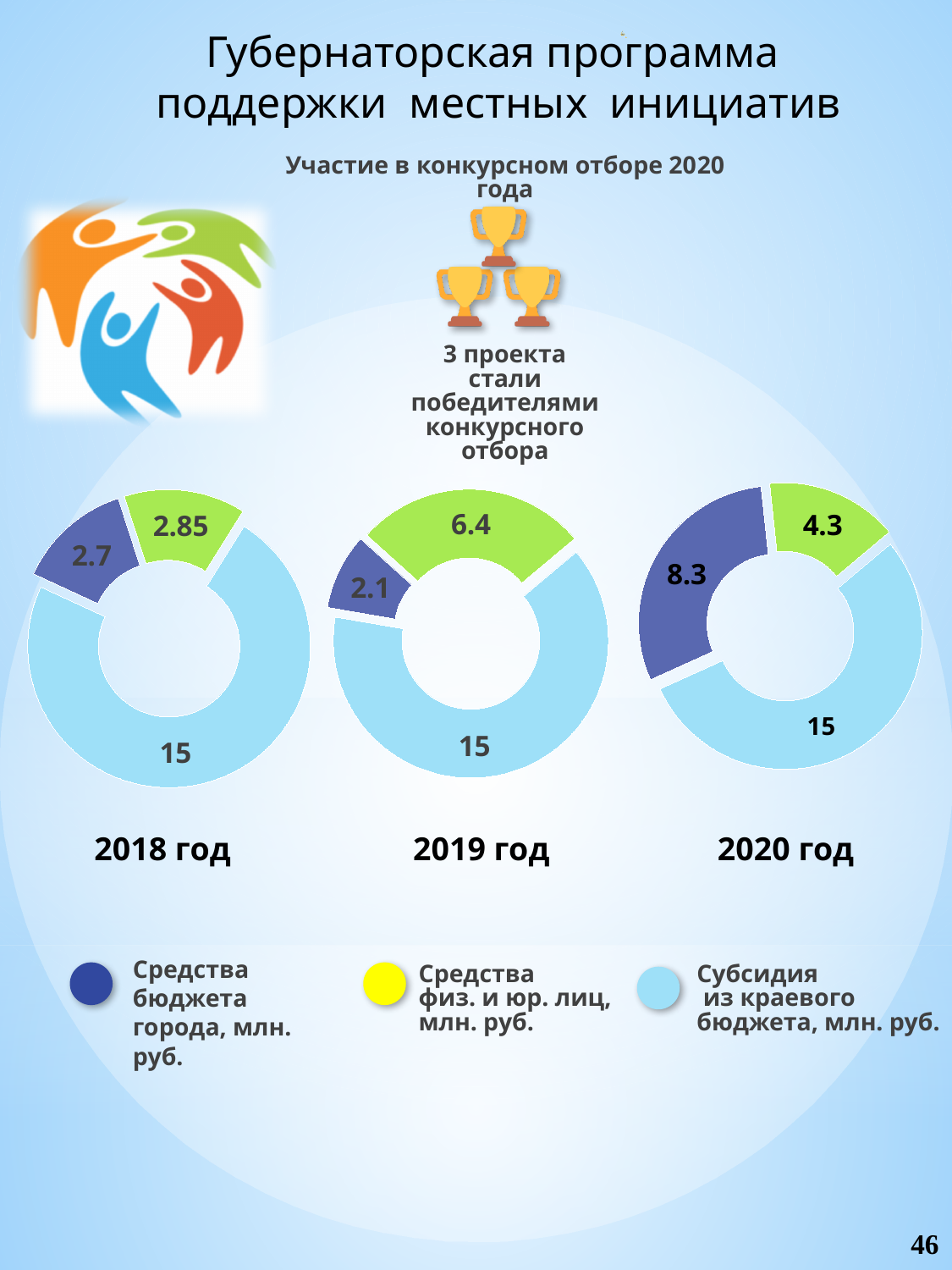
How much larger is the Средства бюджета города value in the 2020 год chart than in the 2018 год chart? 5.6 In the 2019 год chart, what is the value for Субсидия из краевого бюджета? 15 In the 2019 год chart, what value is shown on the green segment? 6.4 In the 2019 год chart, which segment has the smallest value? Средства бюджета города (2.1) In the 2020 год chart, which segment has the largest value? Субсидия из краевого бюджета (15) How many donut charts are shown on the slide? 3 In the 2020 год chart, which is larger: the Средства бюджета города segment or the green segment? Средства бюджета города (8.3) Does the Субсидия из краевого бюджета value change across the 2018, 2019 and 2020 charts? No, it stays at 15 How many entries does the legend list? 3 In the 2020 год chart, what is the value for Средства бюджета города? 8.3 What is the total of the three values shown in the 2019 год chart? 23.5 In the 2018 год chart, what is the value for Средства бюджета города? 2.7